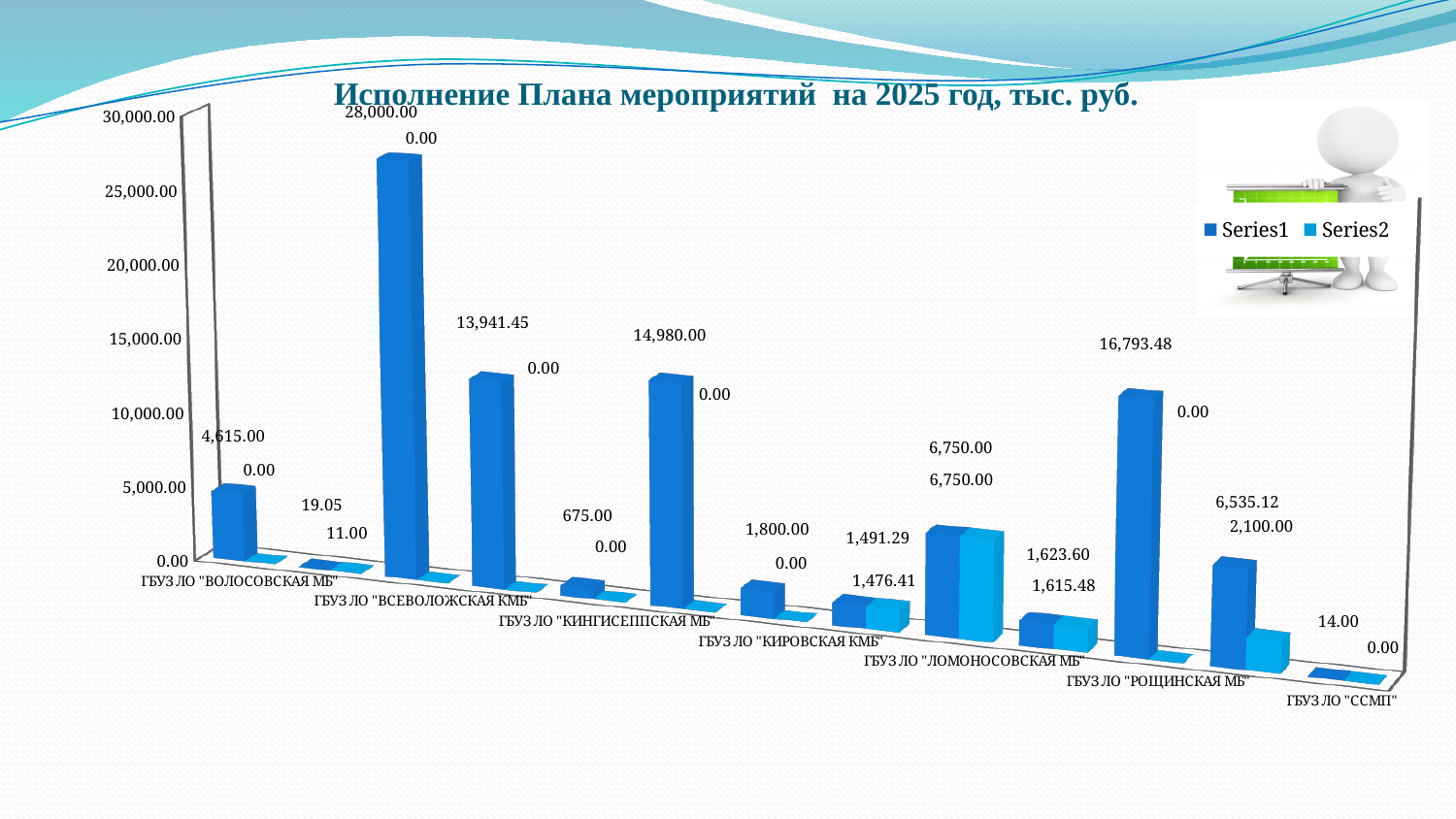
What is the Series1 value for ГБУЗ ЛО "ВОЛОСОВСКАЯ МБ"? 4,615.00 Which has the larger Series1 value, ГБУЗ ЛО "ВОЛОСОВСКАЯ МБ" or ГБУЗ ЛО "ССМП"? ГБУЗ ЛО "ВОЛОСОВСКАЯ МБ" What is the title of the chart? Исполнение Плана мероприятий на 2025 год, тыс. руб. Is the tallest bar in the chart greater or less than 25,000.00? greater What is the Series2 value for ГБУЗ ЛО "ВОЛОСОВСКАЯ МБ"? 0.00 What is the highest value labeled on any bar in the chart? 28,000.00 What is the difference between the Series1 values for ГБУЗ ЛО "ВОЛОСОВСКАЯ МБ" and ГБУЗ ЛО "ССМП"? 4,601.00 How many series does the legend list? 2 What is the Series2 value for ГБУЗ ЛО "ССМП"? 0.00 What kind of chart is shown on the slide? bar chart What are the two legend entries of the chart? Series1, Series2 What is the Series1 value for ГБУЗ ЛО "ССМП"? 14.00